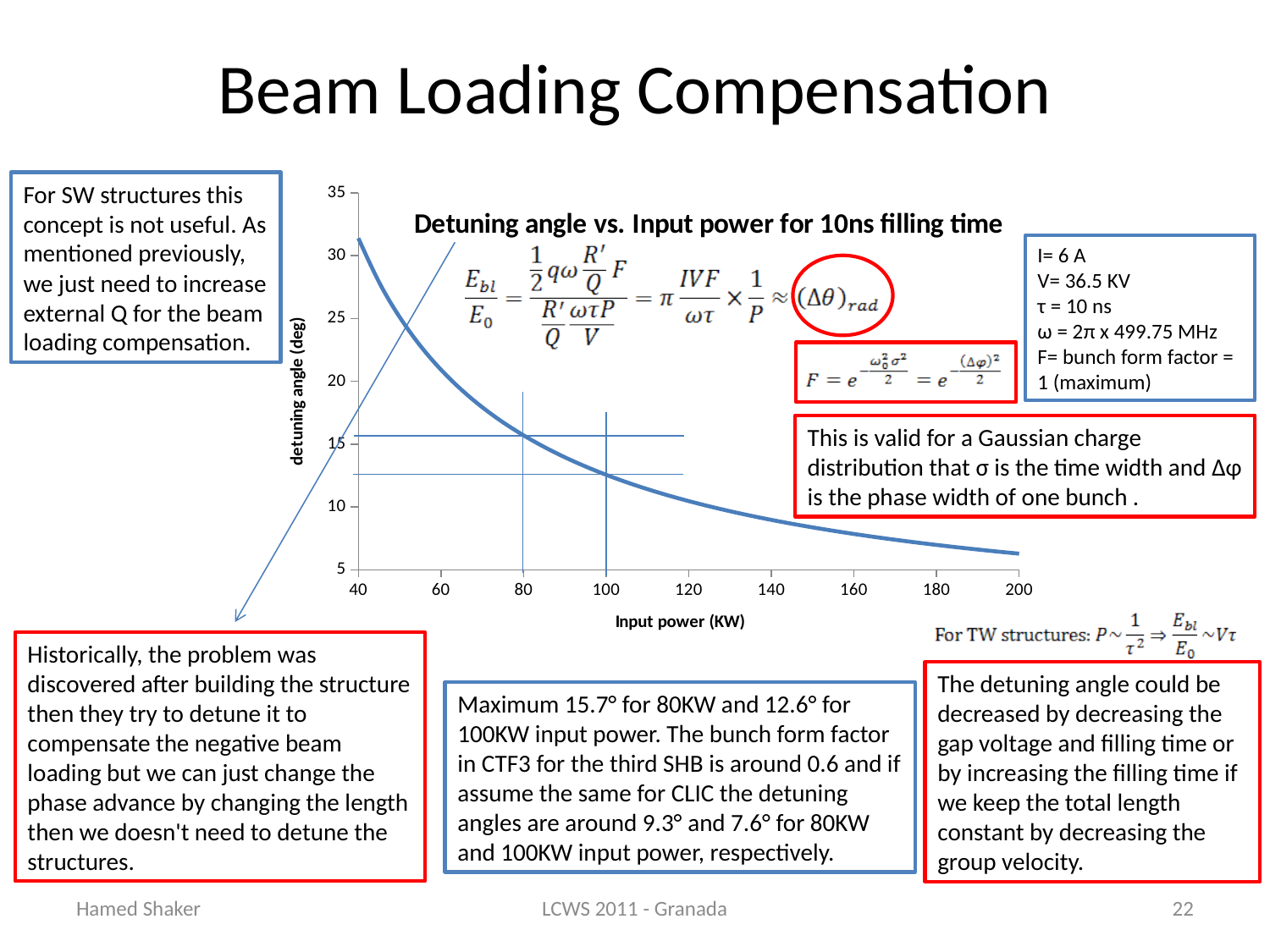
What kind of chart is shown on the slide? line chart According to the slide, what is the detuning angle for 80KW input power? 15.7° Which input power gives the larger detuning angle, 80KW or 100KW? 80KW Is the detuning angle at 100 KW input power greater or less than 10? greater According to the slide, what is the detuning angle for 100KW input power? 12.6° What is the difference between the detuning angle at 80KW and at 100KW input power? 3.1° What is the title of the chart? Detuning angle vs. Input power for 10ns filling time What is the label of the x axis of the chart? Input power (KW) Is the detuning angle at 120 KW input power greater or less than 15? less Is the detuning angle at 200 KW input power greater or less than 10? less How many data series (curves) are plotted on the chart? 1 As input power increases along the x axis, does the detuning angle rise or fall? fall